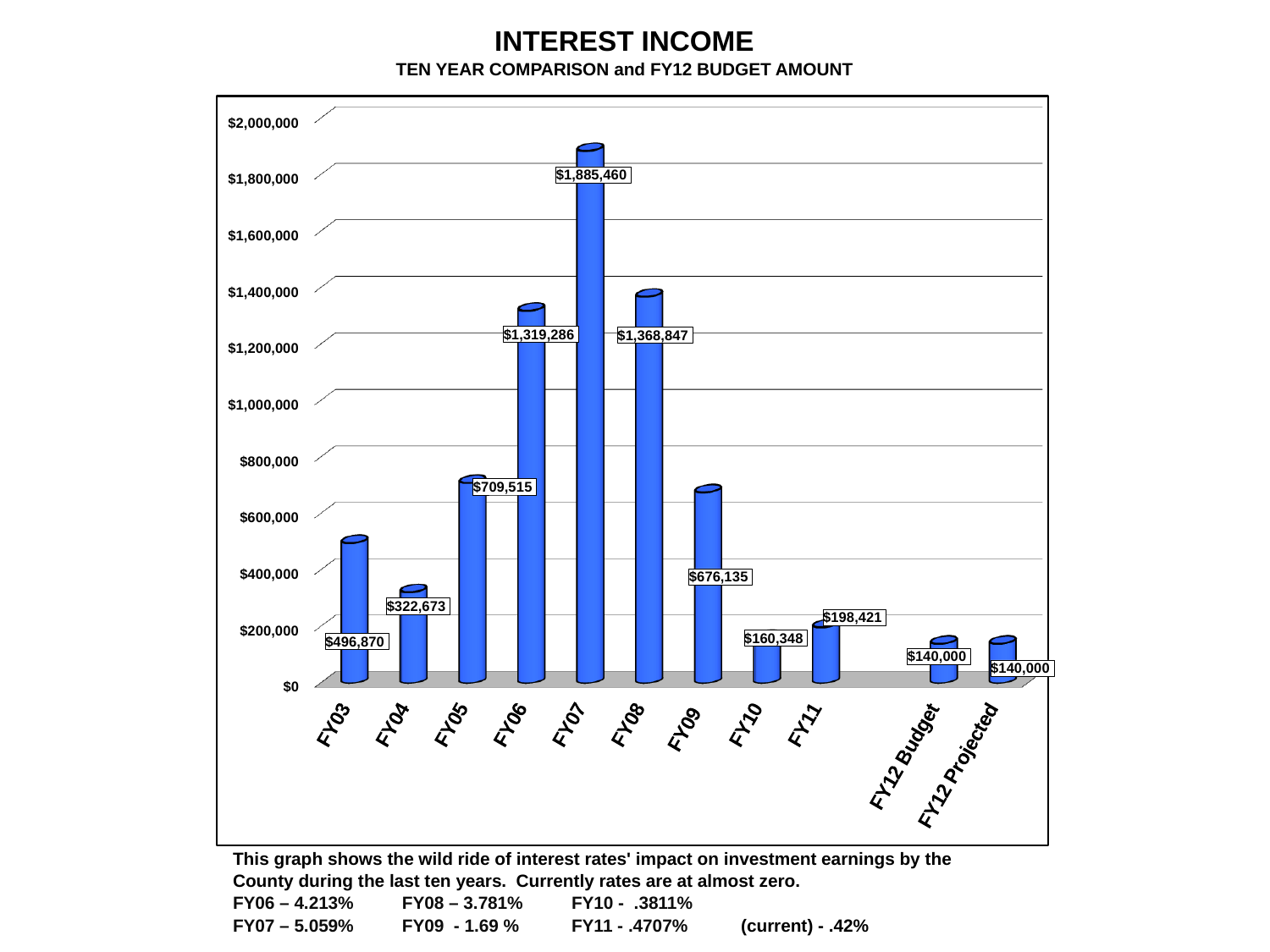
Which is larger, the value for FY03 or the value for FY04? FY03 Which fiscal year has the highest interest income? FY07 What is the value shown for FY12 Budget? $140,000 What is the title of the chart? INTEREST INCOME Do the values rise or fall from FY07 to FY10? fall What is the difference between the FY11 and FY10 values? $38,073 What is the interest income value for FY07? $1,885,460 How many bars are plotted on the chart? 11 Is the value for FY09 greater or less than $600,000? greater What is the difference between the FY08 and FY06 values? $49,561 What kind of chart is shown on the slide? bar chart What is the interest income value for FY10? $160,348